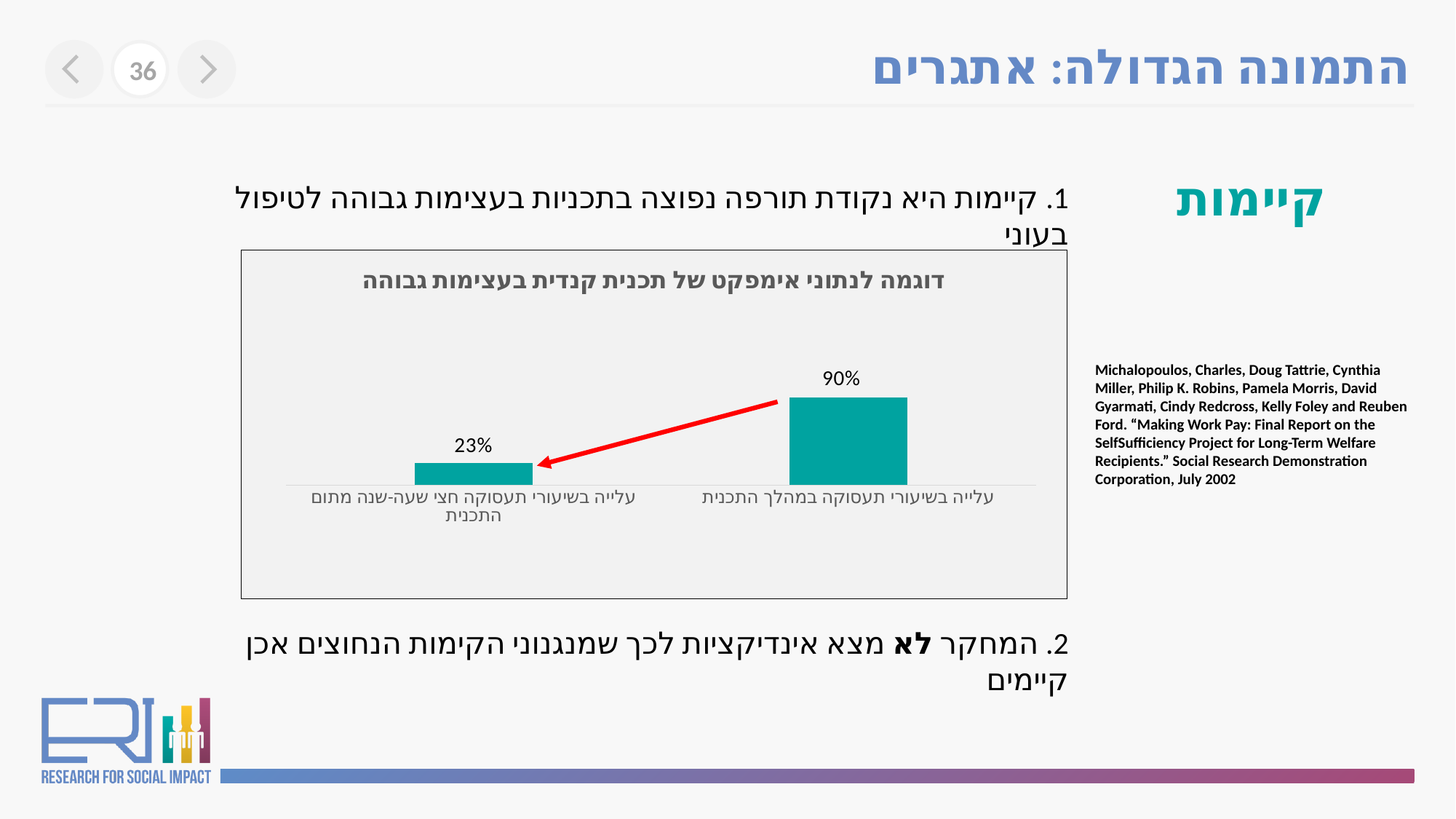
What is the value for 'עלייה בשיעורי תעסוקה חצי שעה-שנה מתום התכנית'? 23% What is the title of the chart? דוגמה לנתוני אימפקט של תכנית קנדית בעצימות גבוהה Which category has the highest value? עלייה בשיעורי תעסוקה במהלך התכנית What is the value for 'עלייה בשיעורי תעסוקה במהלך התכנית'? 90% What colour are the bars in the chart? Teal What kind of chart is shown on the slide? Bar chart How many bars are shown in the chart? 2 Which is larger: the value for 'עלייה בשיעורי תעסוקה במהלך התכנית' or for 'עלייה בשיעורי תעסוקה חצי שעה-שנה מתום התכנית'? עלייה בשיעורי תעסוקה במהלך התכנית What is the difference between the value during the program (במהלך התכנית) and the value after the program (מתום התכנית)? 67% Which category has the lowest value? עלייה בשיעורי תעסוקה חצי שעה-שנה מתום התכנית